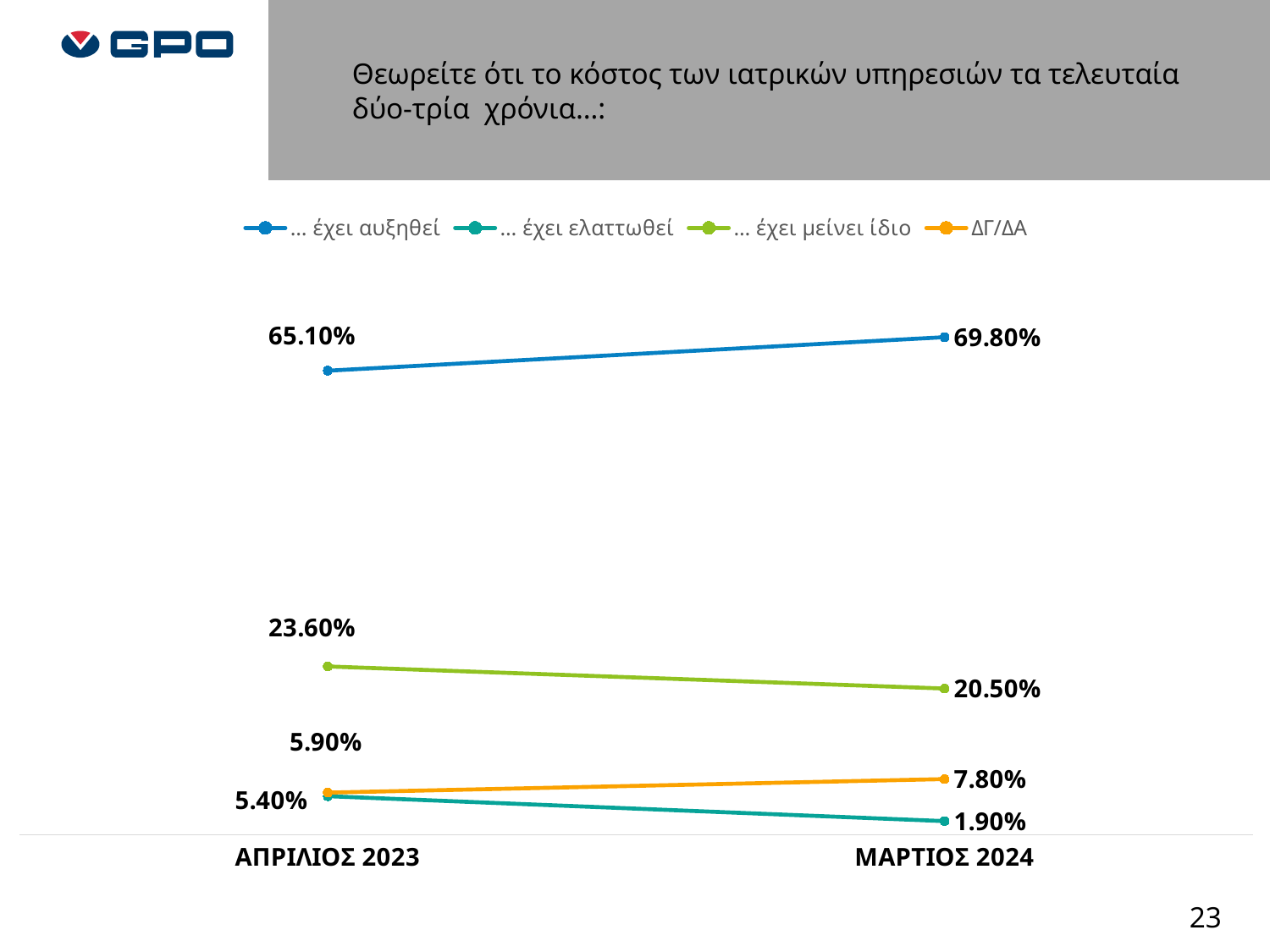
Does the value for "... έχει μείνει ίδιο" rise or fall from ΑΠΡΙΛΙΟΣ 2023 to ΜΑΡΤΙΟΣ 2024? fall Which series has the lowest value in ΜΑΡΤΙΟΣ 2024? ... έχει ελαττωθεί Which series has the highest value in ΜΑΡΤΙΟΣ 2024? ... έχει αυξηθεί What is the value for "... έχει αυξηθεί" in ΜΑΡΤΙΟΣ 2024? 69.80% What type of chart is shown on the slide? line chart What is the value for "... έχει ελαττωθεί" in ΜΑΡΤΙΟΣ 2024? 1.90% How many time points are shown on the x axis? 2 By how much did "... έχει αυξηθεί" change from ΑΠΡΙΛΙΟΣ 2023 to ΜΑΡΤΙΟΣ 2024? 4.70% How many series does the legend list? 4 What is the value for ΔΓ/ΔΑ in ΜΑΡΤΙΟΣ 2024? 7.80% What is the value for "... έχει αυξηθεί" in ΑΠΡΙΛΙΟΣ 2023? 65.10% What is the value for "... έχει μείνει ίδιο" in ΜΑΡΤΙΟΣ 2024? 20.50%